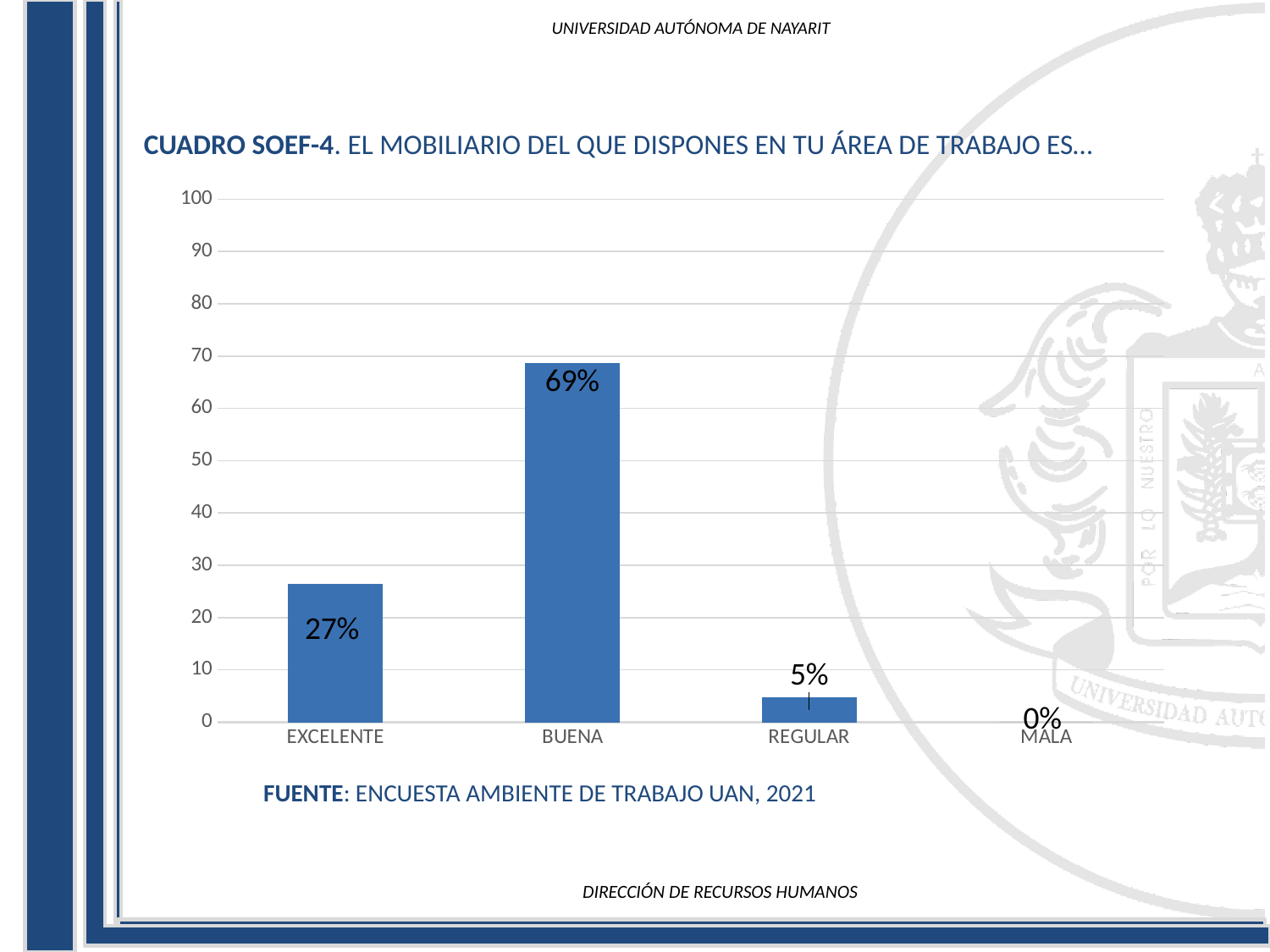
What is the source cited below the chart? ENCUESTA AMBIENTE DE TRABAJO UAN, 2021 What is the value for MALA? 0% What is the value for EXCELENTE? 27% What is the value for BUENA? 69% Which is larger, the value for EXCELENTE or the value for REGULAR? EXCELENTE What is the difference between the values for BUENA and EXCELENTE? 42% Which category has the highest value? BUENA Is the value for BUENA greater or less than 60? greater What is the value for REGULAR? 5% Which category has the lowest value? MALA How many categories are shown on the x axis? 4 What kind of chart is shown on the slide? Bar chart